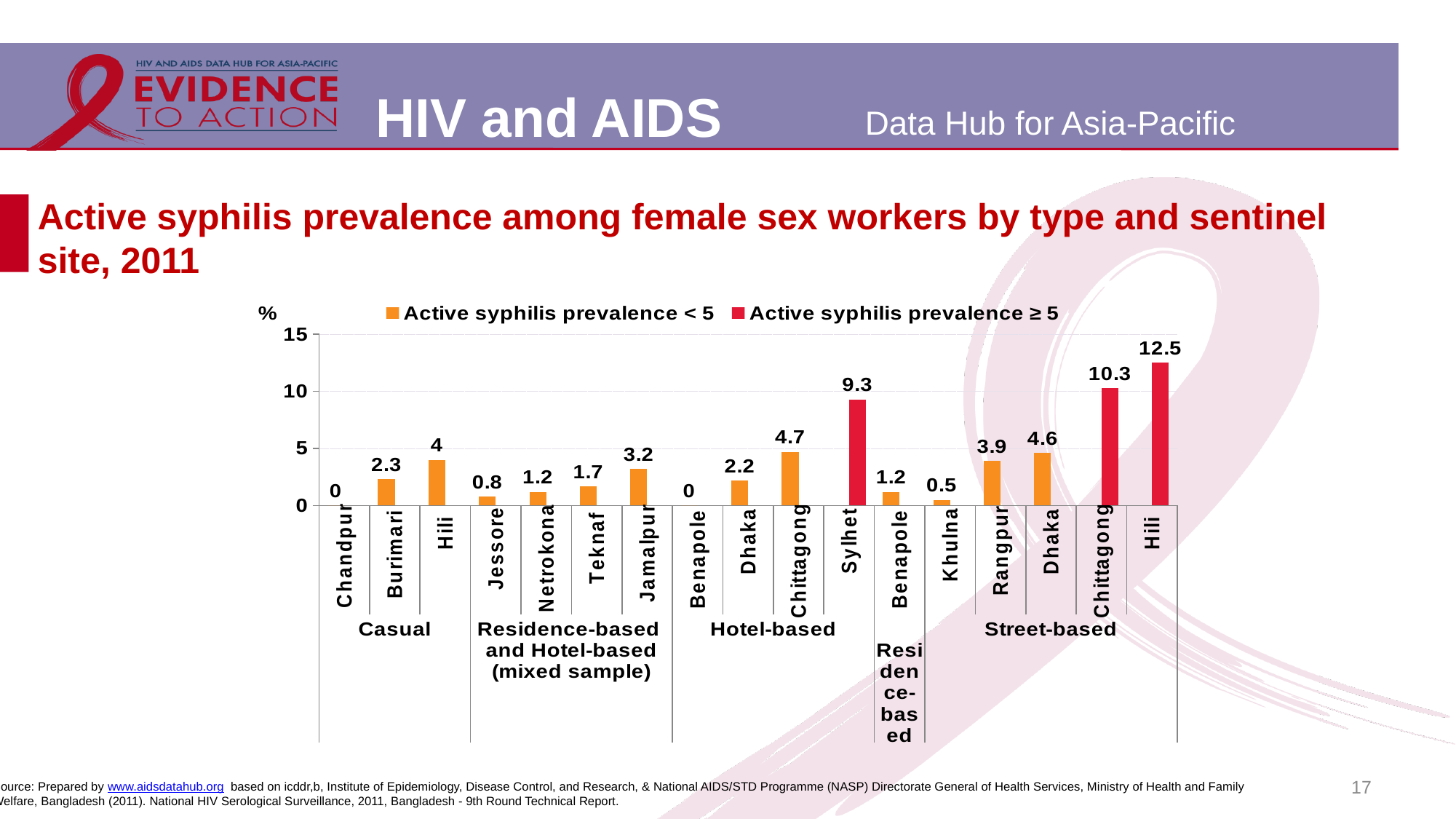
Which is larger: the value for Dhaka in the street-based group or Dhaka in the hotel-based group? Dhaka (Street-based) How many series does the legend list? 2 What is the active syphilis prevalence for Sylhet in the hotel-based group? 9.3 How many sentinel site bars are plotted on the chart? 17 Is the value for Sylhet greater or less than 5? greater Which sentinel site has the highest active syphilis prevalence on the chart? Hili (Street-based) What is the difference between the values for Chittagong in the street-based group and Chittagong in the hotel-based group? 5.6 What is the active syphilis prevalence for Hili among street-based female sex workers? 12.5 What kind of chart is shown on the slide? Bar chart Which colour is used for the series 'Active syphilis prevalence ≥ 5'? Red What is the value for Jamalpur in the residence-based and hotel-based (mixed sample) group? 3.2